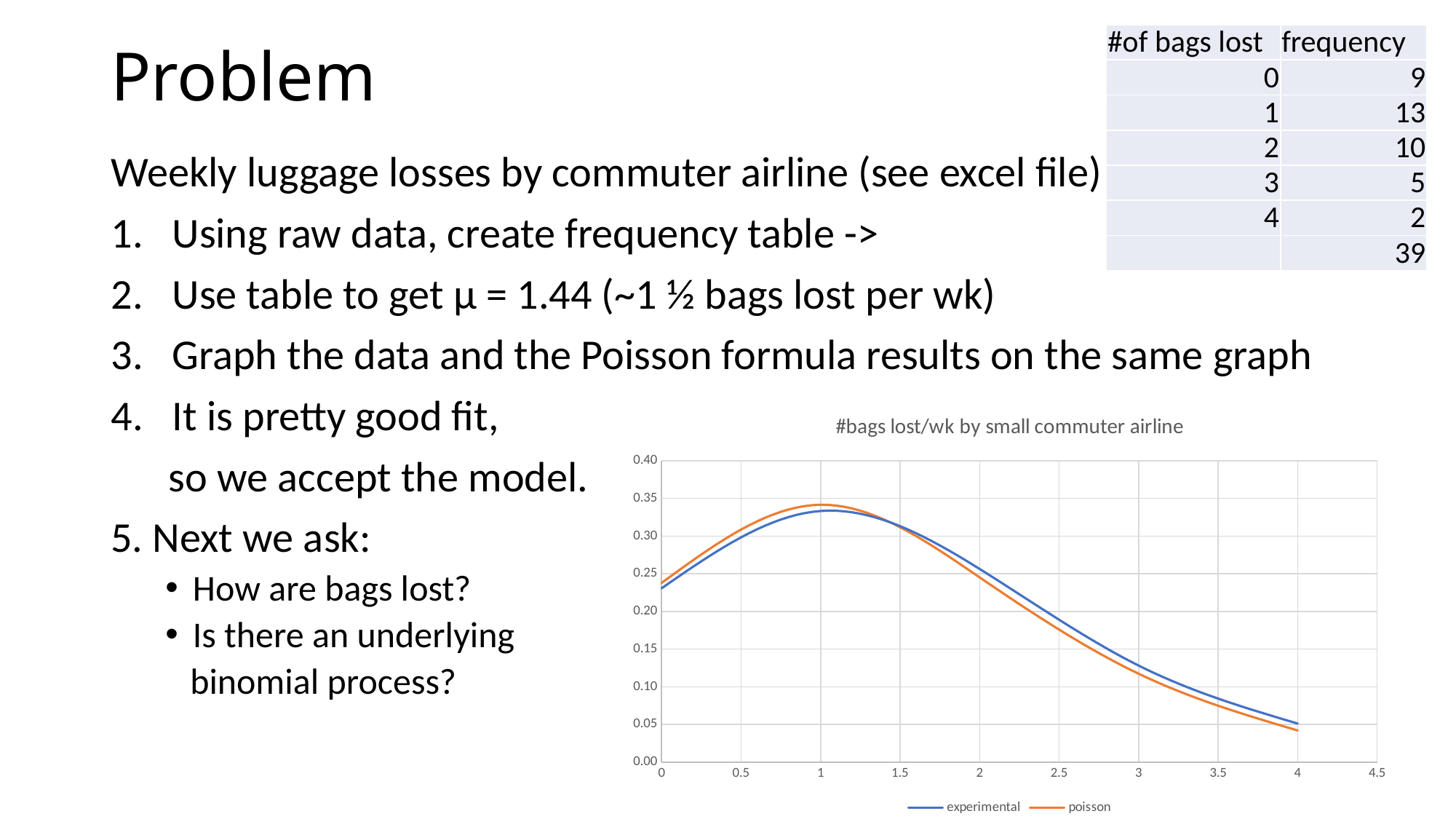
Is the value of the experimental series at x = 4 greater or less than 0.10? less Is the value of the poisson series at x = 0 greater or less than 0.20? greater Is the value of the poisson series at x = 1 greater or less than 0.30? greater What is the title of the chart? #bags lost/wk by small commuter airline At which x value does the experimental series reach its highest point? 1 At x = 2.5, which series has the lower value, experimental or poisson? poisson What kind of chart is shown on the slide? line chart What are the two series named in the chart's legend? experimental and poisson At x = 4, which series has the higher value, experimental or poisson? experimental Between x = 1 and x = 4, do the values of the experimental series rise or fall? fall How many series does the chart's legend list? 2